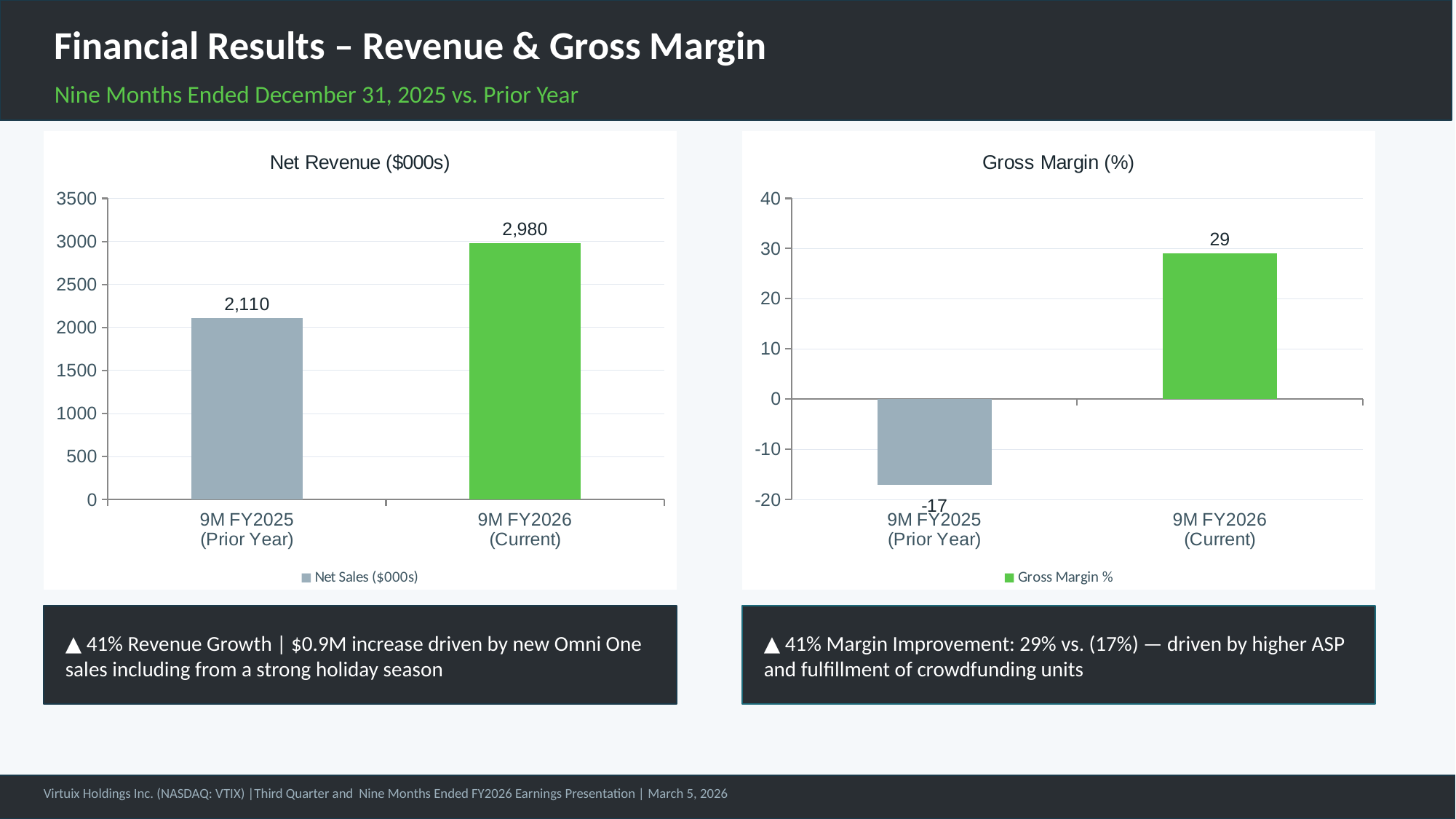
In the Gross Margin (%) chart, what is the value for 9M FY2026 (Current)? 29 In the Net Revenue ($000s) chart, what is the value for 9M FY2026 (Current)? 2,980 In the Net Revenue ($000s) chart, is the value for 9M FY2025 greater or less than 2500? less How many categories are shown in the Net Revenue ($000s) chart? 2 What is the legend entry shown in the Gross Margin (%) chart? Gross Margin % In the Gross Margin (%) chart, what is the difference between the 9M FY2026 and 9M FY2025 values? 46 In the Net Revenue ($000s) chart, which period has the higher value? 9M FY2026 (Current) In the Gross Margin (%) chart, what is the value for 9M FY2025 (Prior Year)? -17 In the Gross Margin (%) chart, which period has the lowest value? 9M FY2025 (Prior Year) In the Net Revenue ($000s) chart, what is the difference between the 9M FY2026 and 9M FY2025 values? 870 In the Net Revenue ($000s) chart, what is the value for 9M FY2025 (Prior Year)? 2,110 What kind of chart is the Gross Margin (%) chart? Bar chart